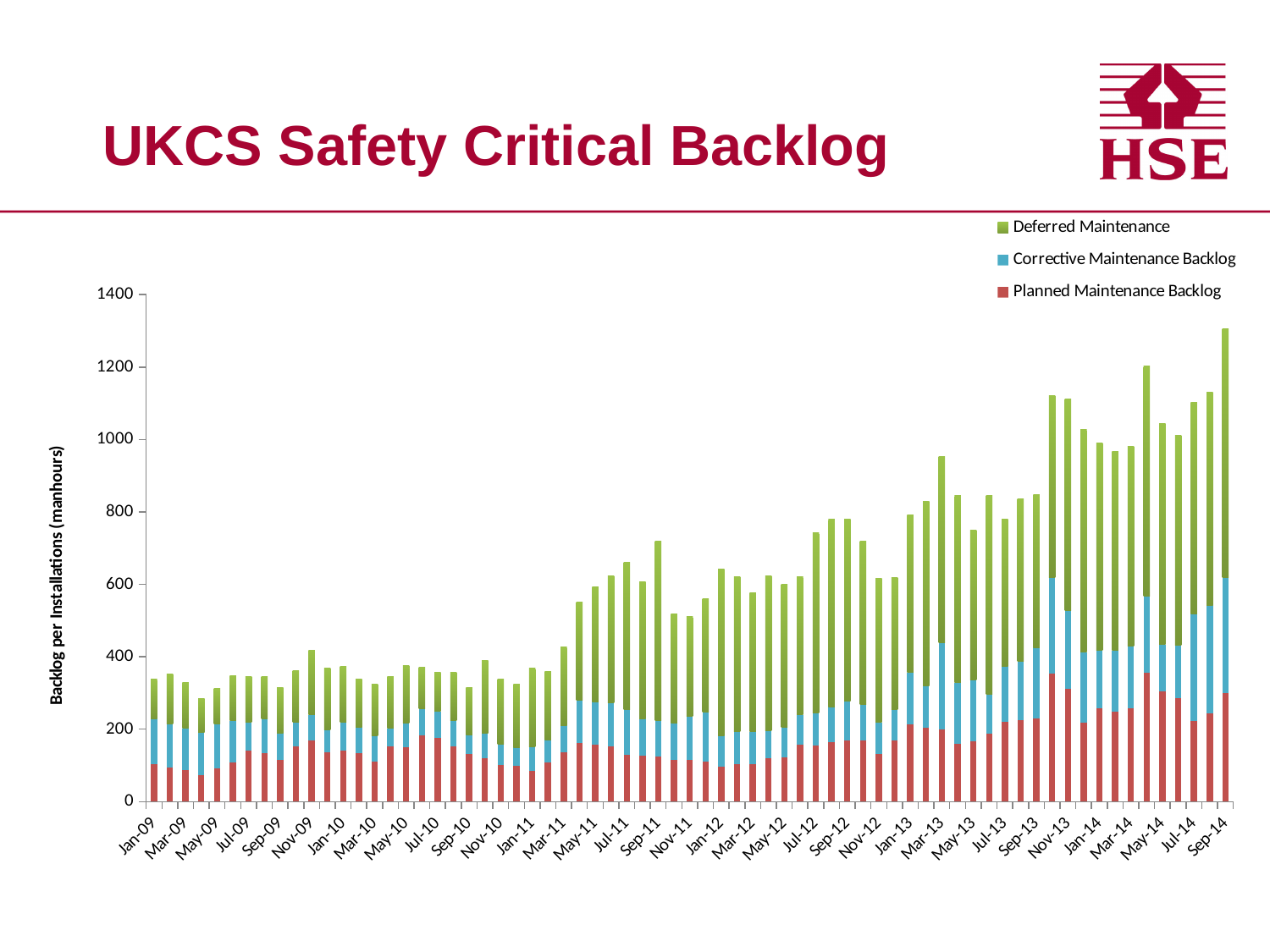
What kind of chart is shown on the slide? Stacked bar chart Is the total backlog for Jul-12 greater or less than 600? greater Is the total backlog for Sep-14 greater or less than 1200? greater Overall, does the total backlog rise or fall from Jan-09 to Sep-14? rise How many series does the legend list? 3 Is the total backlog for Jan-09 greater or less than 400? less Which month has the highest total backlog? Sep-14 What are the three series named in the legend? Deferred Maintenance, Corrective Maintenance Backlog, Planned Maintenance Backlog Which has the larger total backlog, Jan-09 or Sep-14? Sep-14 Which has the larger total backlog, Mar-12 or Mar-13? Mar-13 What is the label on the vertical axis? Backlog per Installations (manhours)